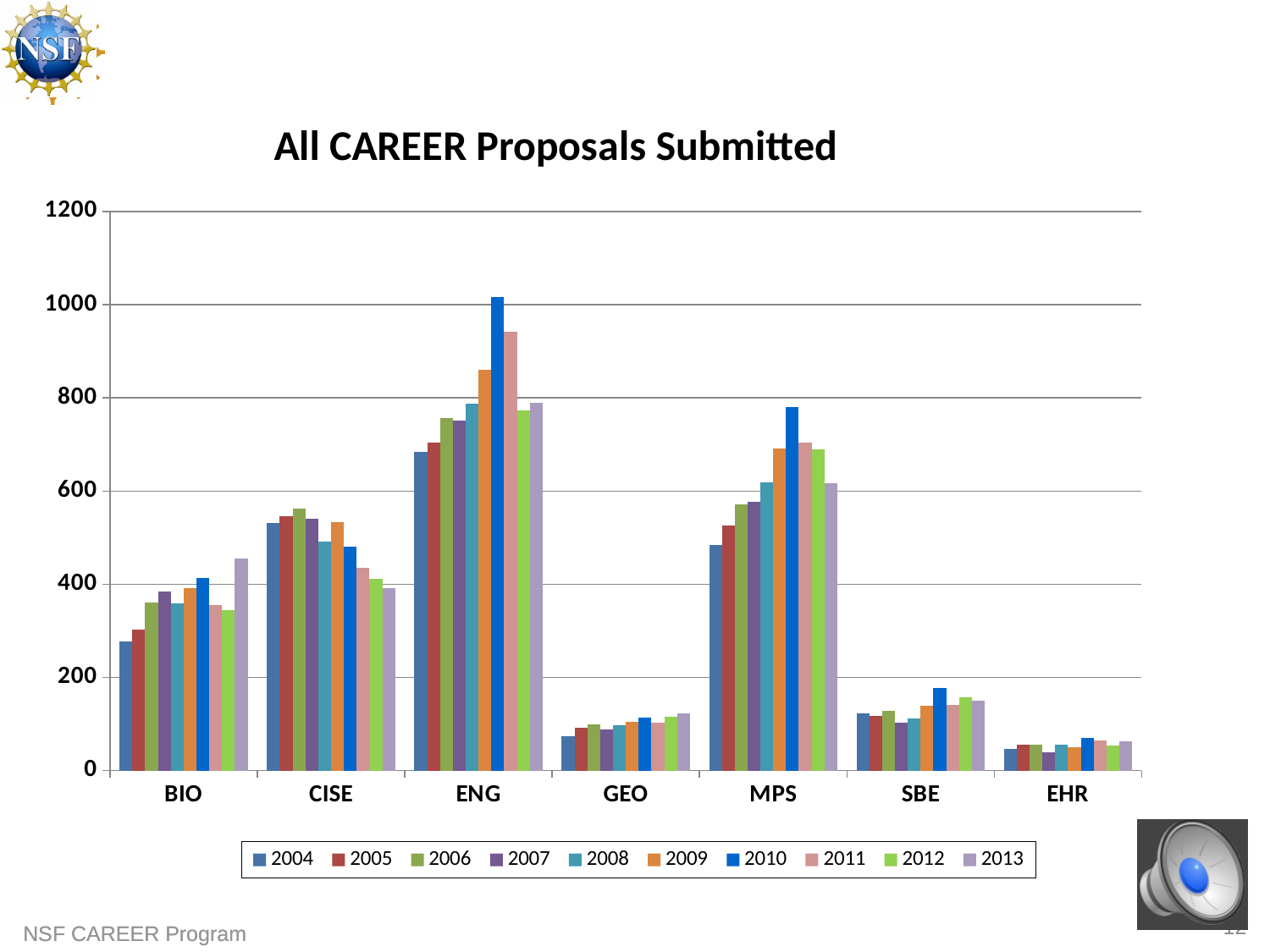
Is the value for ENG in 2010 greater or less than 1000? greater Which year has the highest value within the ENG category? 2010 What kind of chart is shown on the slide? bar chart What is the title of the chart? All CAREER Proposals Submitted Which category has the lowest bars overall? EHR Is the value for SBE in 2010 greater or less than 200? less Is the value for MPS in 2010 greater or less than 800? less Within the MPS category, do the values rise or fall from 2004 to 2010? rise How many categories are shown on the x axis? 7 How many series does the legend list? 10 Which is larger: the 2010 value for MPS or the 2010 value for CISE? MPS Which category has the tallest bar in the chart? ENG